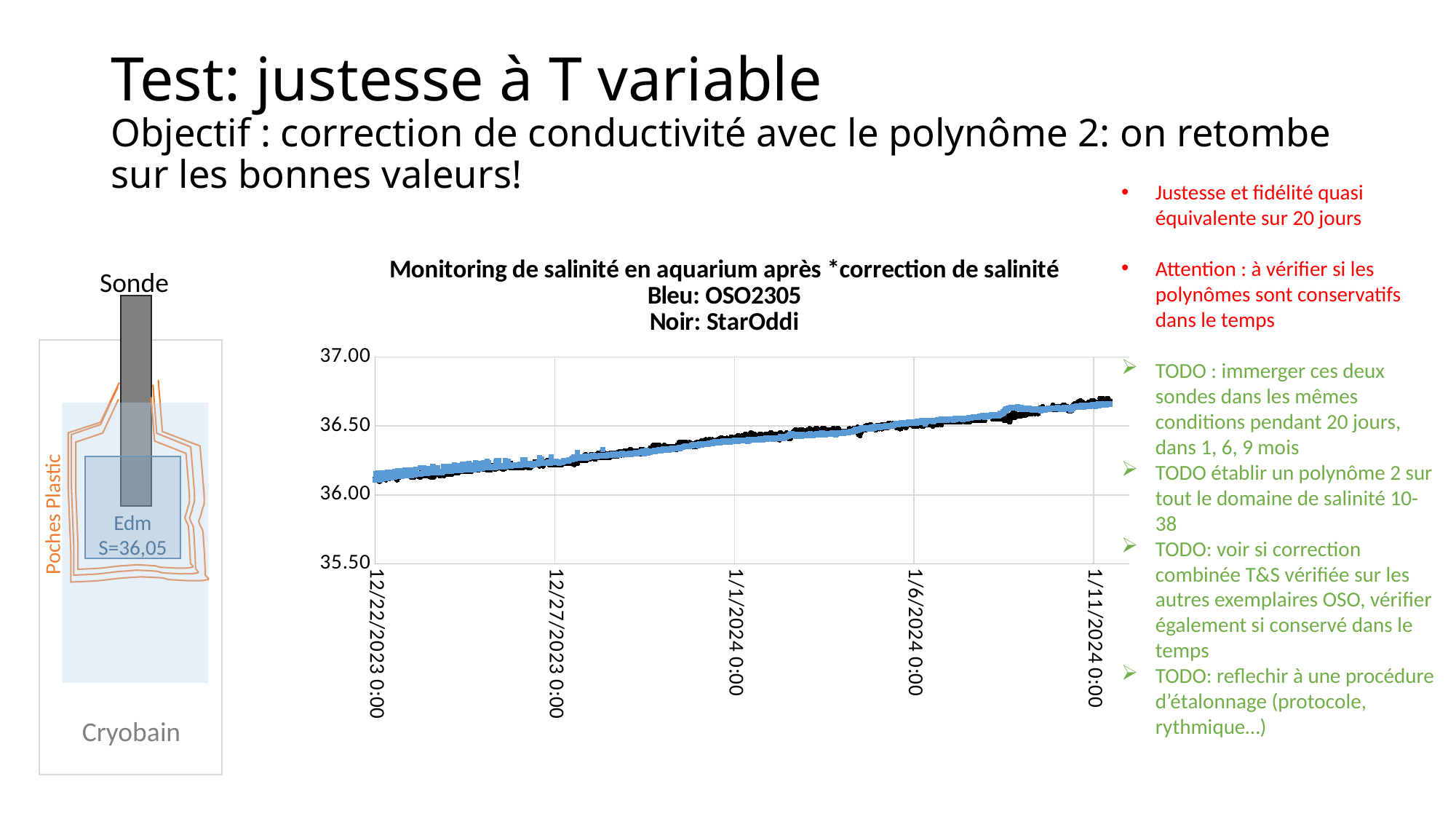
Is the salinity value at 1/11/2024 0:00 greater or less than 37.00? less Is the salinity value at 1/11/2024 0:00 greater or less than 36.50? greater What is the highest value shown on the y axis? 37.00 Is the salinity value at 12/22/2023 0:00 greater or less than 36.50? less According to the chart title, which series is drawn in blue? OSO2305 How many date labels are shown on the x axis? 5 How many data series are plotted on the chart? 2 What is the first line of the chart's title? Monitoring de salinité en aquarium après *correction de salinité What kind of chart is shown on the slide? line chart Do the salinity values rise or fall from 12/22/2023 to 1/11/2024? rise